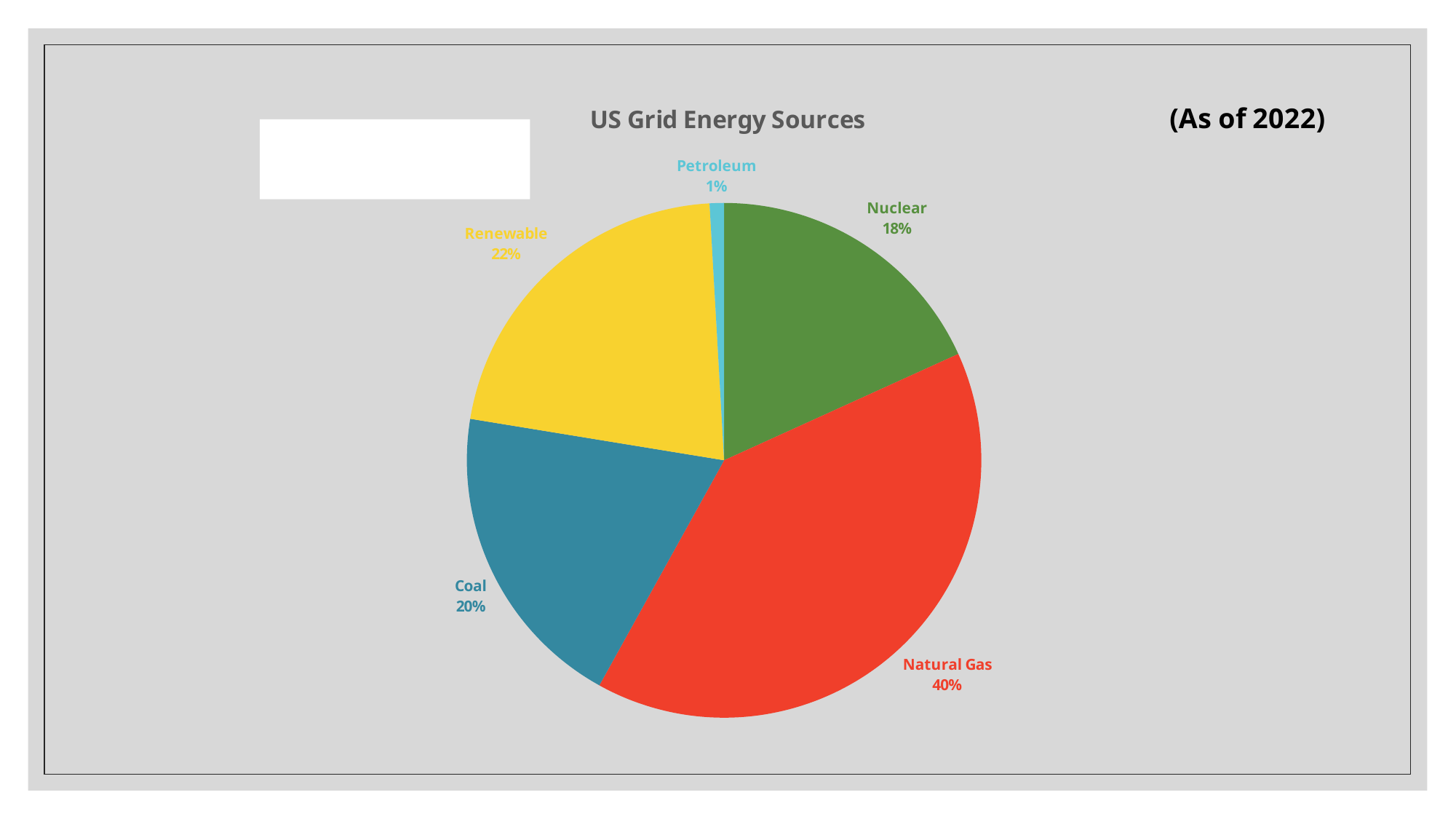
What is the difference in percentage points between Natural Gas and Coal? 20 What is the title of the chart? US Grid Energy Sources What percentage does Nuclear contribute? 18% Which energy source has the smallest share of the pie? Petroleum Which energy source has the largest share of the pie? Natural Gas What percentage of the pie is Renewable? 22% What type of chart is shown on the slide? Pie chart How many energy sources are shown in the pie chart? 5 Which has a larger share, Renewable or Nuclear? Renewable What is the difference in percentage points between Renewable and Nuclear? 4 What is the value shown for Coal? 20% What share of US grid energy sources does Natural Gas account for? 40%